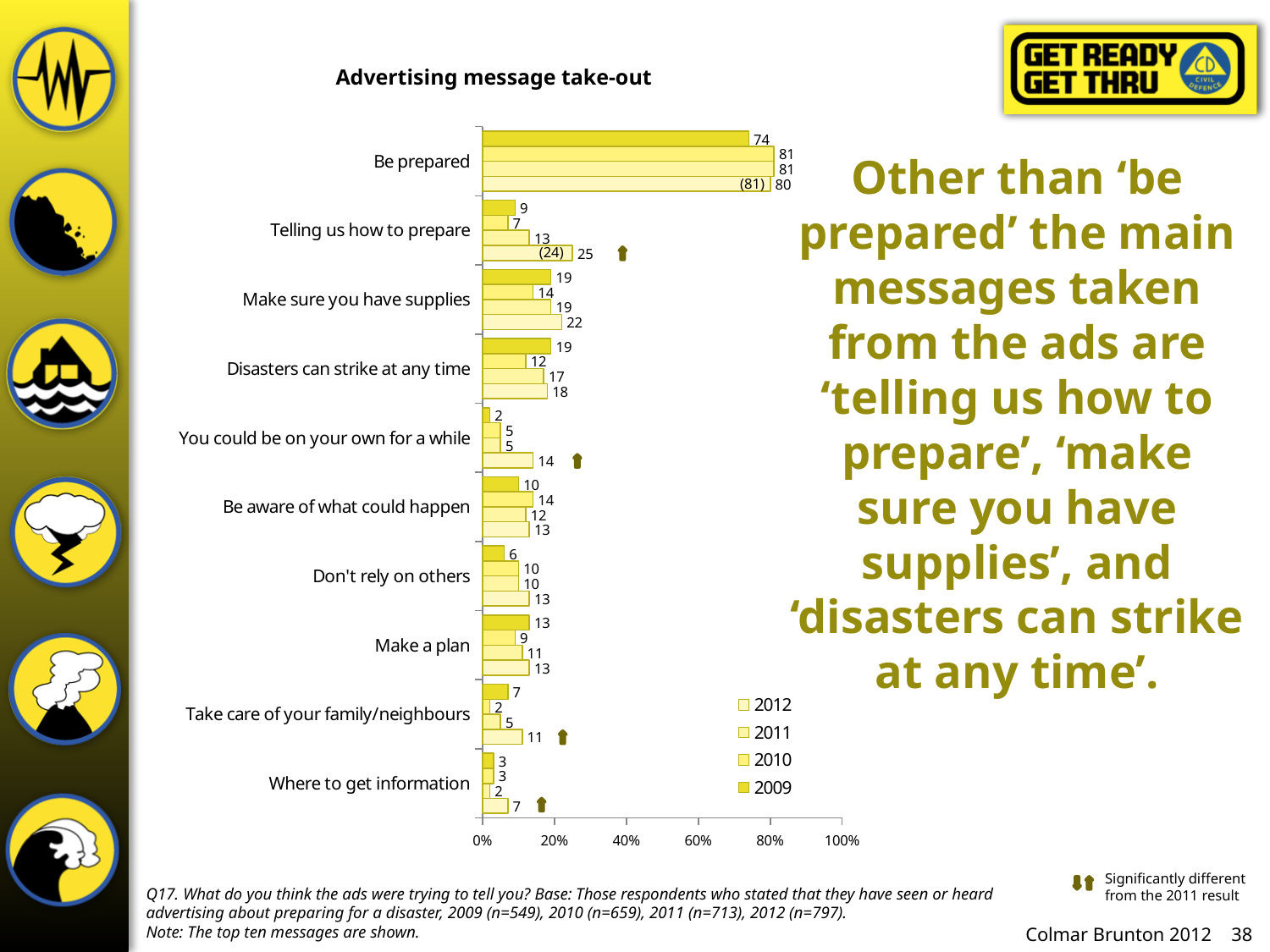
Is the 2012 value for 'Be prepared' greater or less than 60%? greater What is the title of the chart? Advertising message take-out In 2012, which is larger: 'Make sure you have supplies' or 'Disasters can strike at any time'? Make sure you have supplies What is the difference between the 2012 value (22) and the 2009 value (19) for 'Make sure you have supplies'? 3 Which message category has the highest values across all years? Be prepared What kind of chart is shown on the slide? Bar chart How many series does the chart's legend list? 4 What is the 2012 value for 'Where to get information'? 7 What is the 2012 value for 'Be prepared'? 80 What is the 2009 value for 'Be prepared'? 74 What is the 2012 value for 'Telling us how to prepare'? 25 How many message categories are plotted on the chart? 10